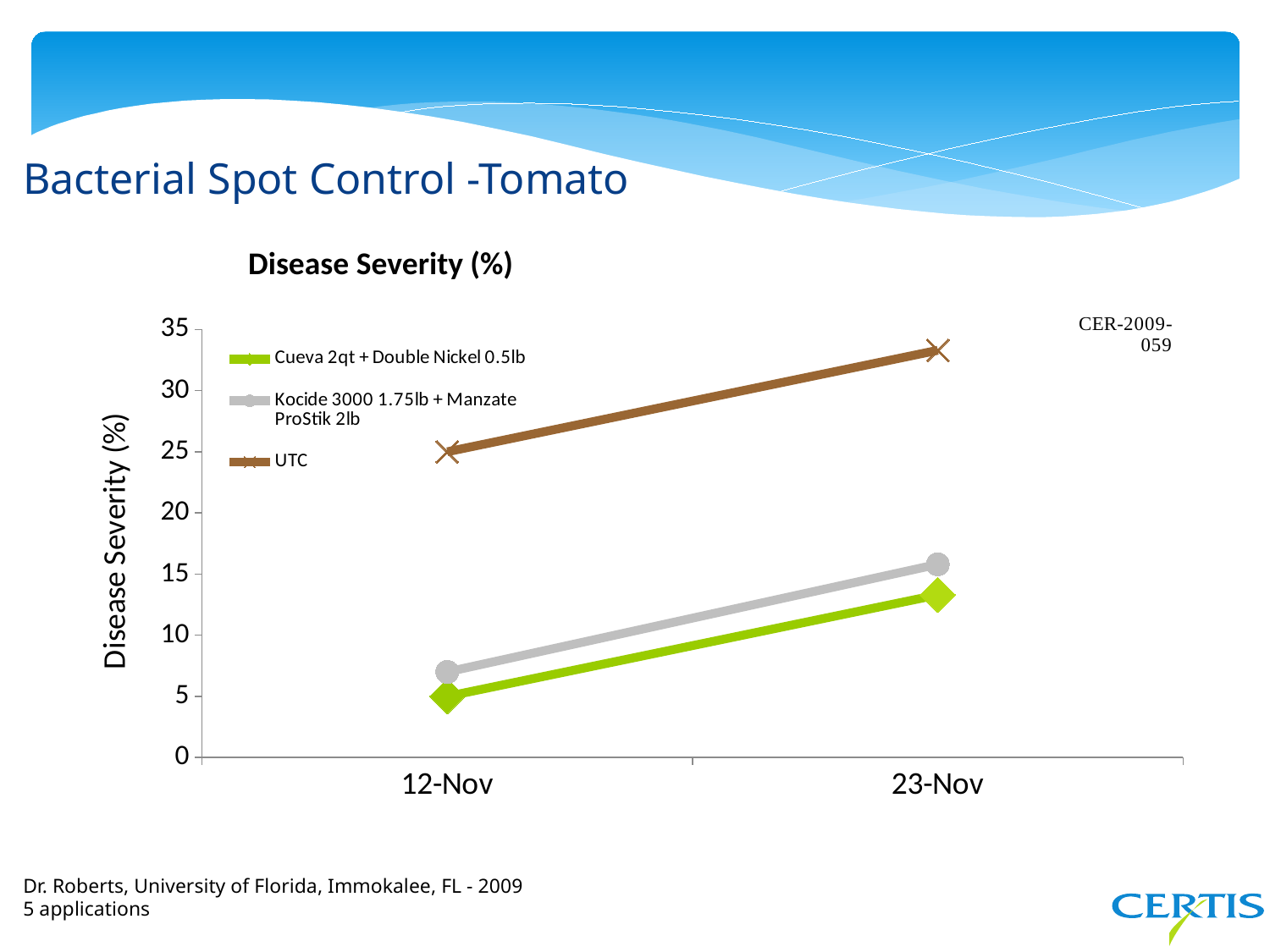
Is the disease severity for UTC on 23-Nov greater or less than 30? greater What is the title of the chart? Disease Severity (%) Which series has the lowest disease severity on 12-Nov? Cueva 2qt + Double Nickel 0.5lb Which series has the lowest disease severity on 23-Nov? Cueva 2qt + Double Nickel 0.5lb Is the disease severity for Kocide 3000 1.75lb + Manzate ProStik 2lb on 12-Nov greater or less than 10? less On 12-Nov, which has the higher disease severity: UTC or Kocide 3000 1.75lb + Manzate ProStik 2lb? UTC What kind of chart is shown on the slide? line chart Which series has the highest disease severity on 23-Nov? UTC Is the disease severity for Cueva 2qt + Double Nickel 0.5lb on 23-Nov greater or less than 10? greater How many series does the legend list? 3 Does the disease severity for UTC rise or fall from 12-Nov to 23-Nov? rise How many dates are shown on the x axis? 2